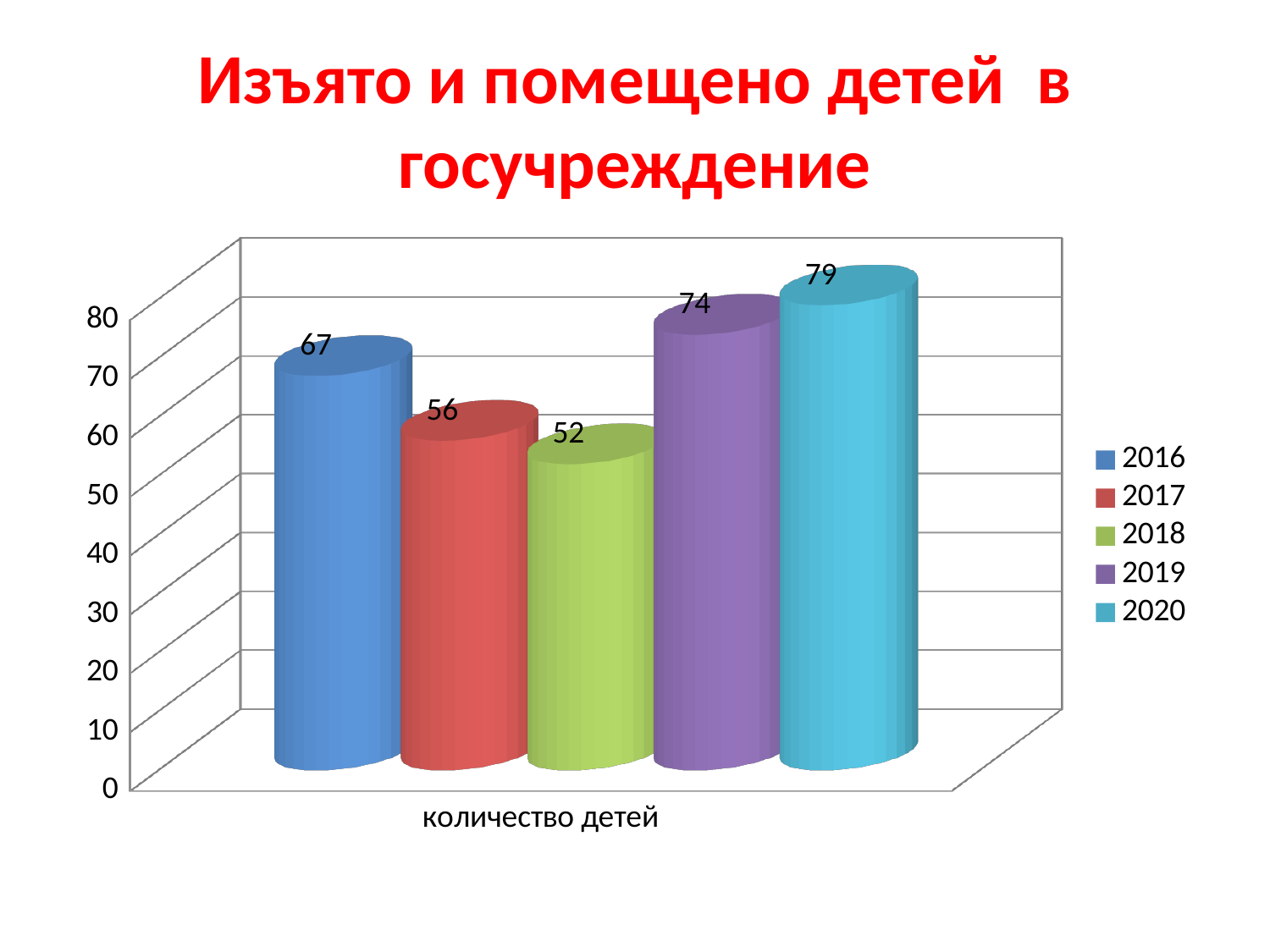
What is the value for 2018? 52 What is the difference between the values for 2020 and 2016? 12 What is the difference between the values for 2019 and 2017? 18 What is the label on the x axis? количество детей Which is larger, the value for 2017 or the value for 2019? 2019 What kind of chart is shown on the slide? bar chart What is the title of the chart? Изъято и помещено детей в госучреждение What is the value for 2016? 67 Which year has the highest value? 2020 Which year has the lowest value? 2018 What is the value for 2020? 79 How many series does the legend list? 5